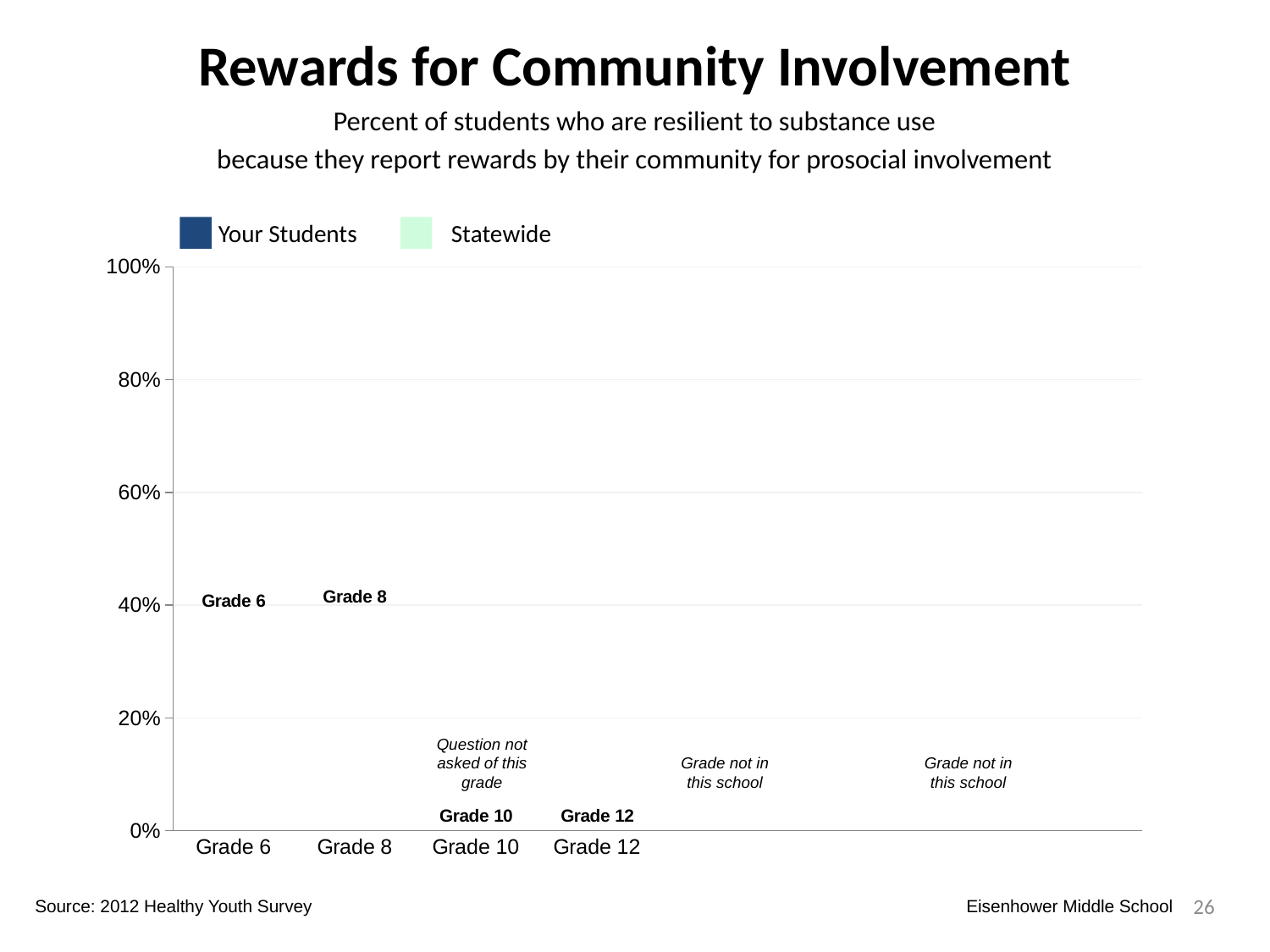
What is the highest value shown on the y axis? 100% How many series does the legend list? 2 What is the title of the chart? Rewards for Community Involvement How many grade categories are shown on the x axis? 4 What note is shown for Grade 12 on the chart? Grade not in this school What note is shown for Grade 10 on the chart? Question not asked of this grade What is the source cited for the chart data? 2012 Healthy Youth Survey What are the two series named in the legend? Your Students and Statewide